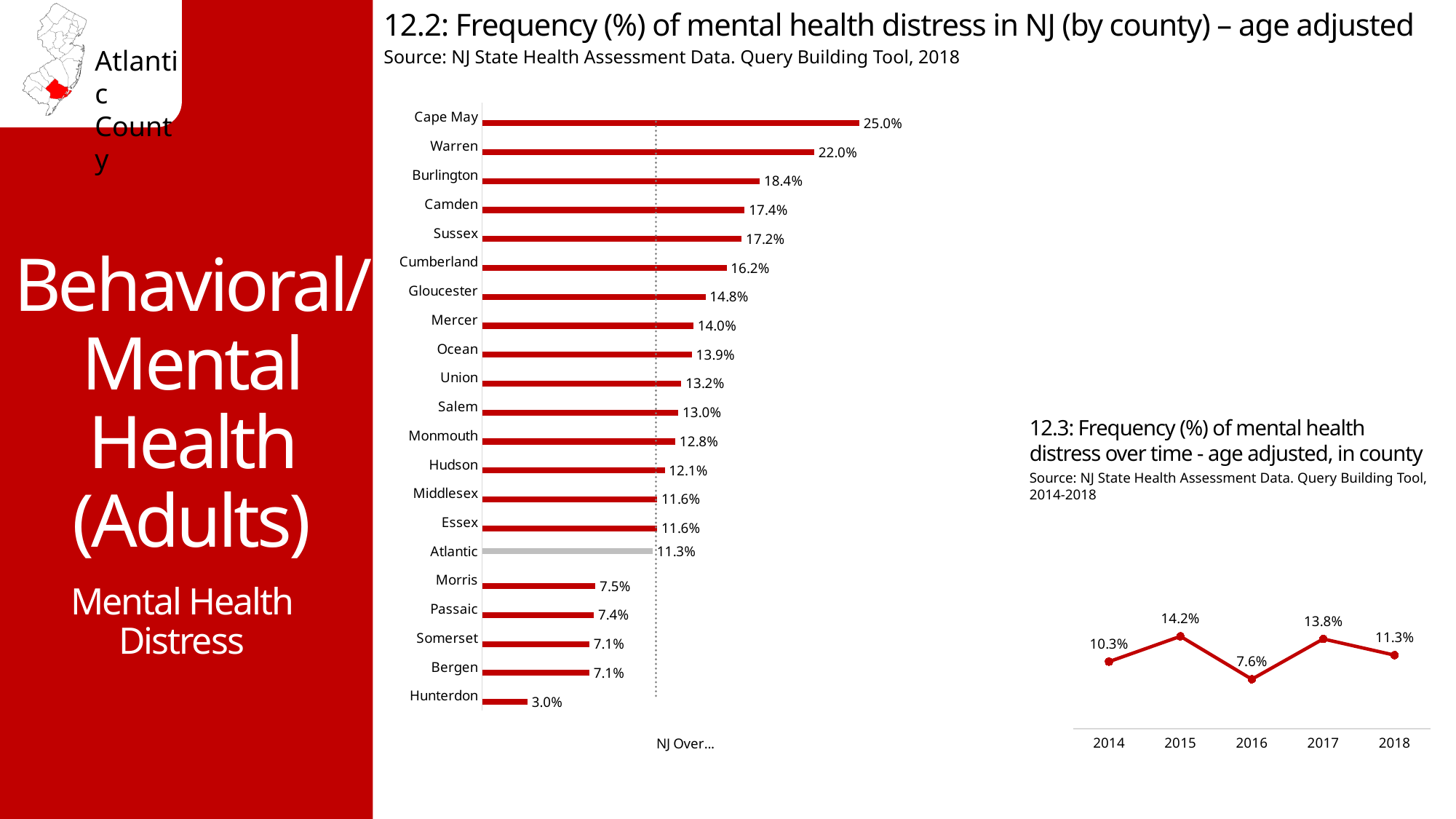
In chart 12.3 (mental health distress over time in county), what is the difference between 2017 and 2018? 2.5% In chart 12.2 (frequency of mental health distress by county), what is the value for Atlantic? 11.3% In chart 12.2 (frequency of mental health distress by county), which county has the lowest value? Hunterdon In chart 12.3 (mental health distress over time in county), which year has the highest value? 2015 In chart 12.2 (frequency of mental health distress by county), how many counties are plotted? 21 In chart 12.2 (frequency of mental health distress by county), what is the difference between Warren and Burlington? 3.6% What kind of chart is chart 12.3 (mental health distress over time in county)? Line chart In chart 12.2 (frequency of mental health distress by county), what is the value for Cape May? 25.0% In chart 12.2 (frequency of mental health distress by county), which is larger, Camden or Gloucester? Camden In chart 12.2 (frequency of mental health distress by county), which county has the highest value? Cape May What kind of chart is chart 12.2 (frequency of mental health distress by county)? Bar chart In chart 12.3 (mental health distress over time in county), what is the value for 2016? 7.6%